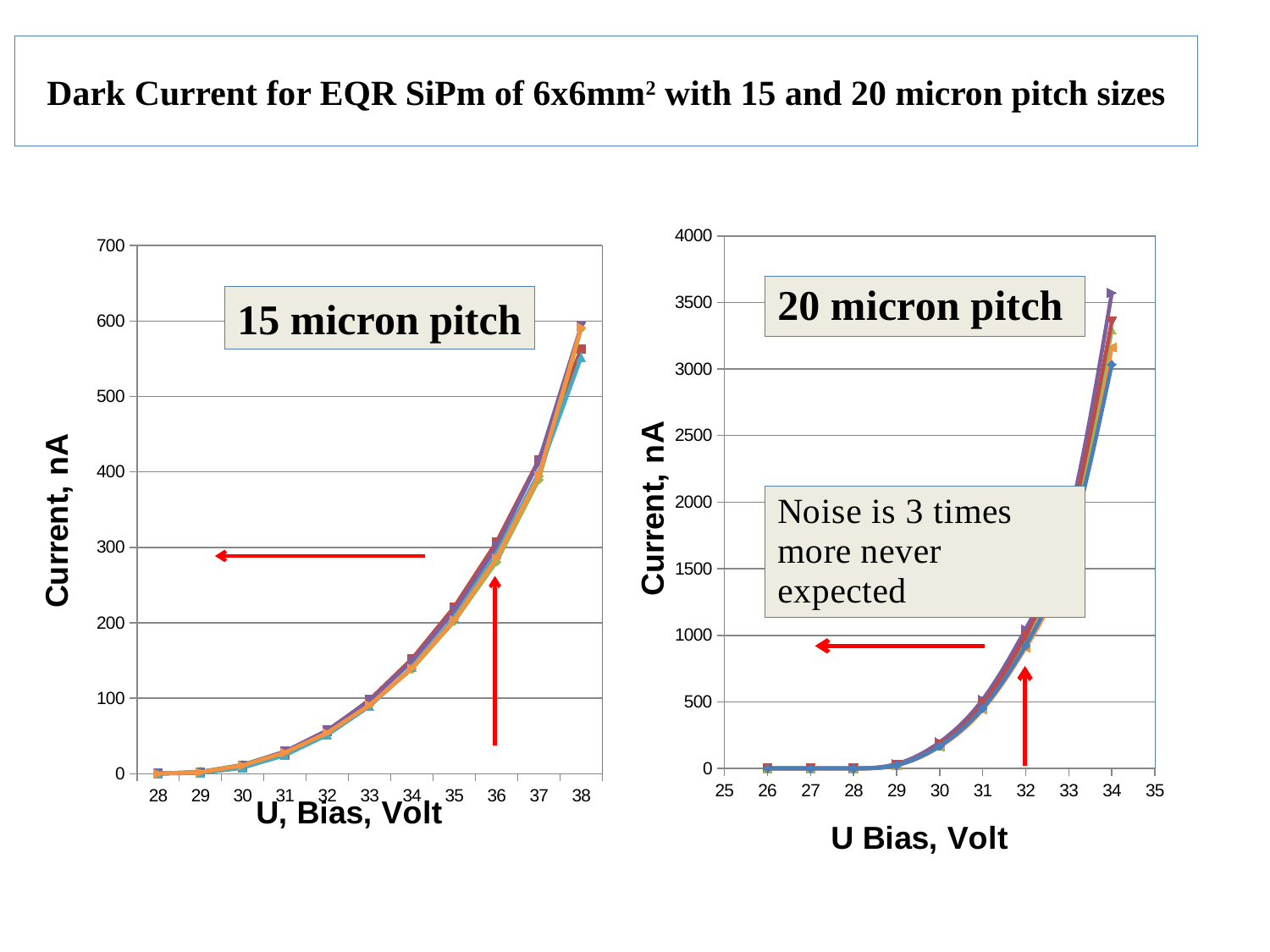
What kind of chart is the left chart labelled '15 micron pitch'? line chart In the right chart (20 micron pitch), does the current rise or fall as the bias voltage increases? rise What is the y-axis title of the left chart (15 micron pitch)? Current, nA In the left chart (15 micron pitch), how many bias voltage points are plotted along the x axis? 11 In the right chart (20 micron pitch), is the current at 30 V greater or less than 500 nA? less In the left chart (15 micron pitch), does the current rise or fall as the bias voltage increases? rise In the left chart (15 micron pitch), is the current at 38 V greater or less than 500 nA? greater In the left chart (15 micron pitch), is the current at 32 V greater or less than 100 nA? less What is the x-axis title of the right chart (20 micron pitch)? U Bias, Volt What kind of chart is the right chart labelled '20 micron pitch'? line chart